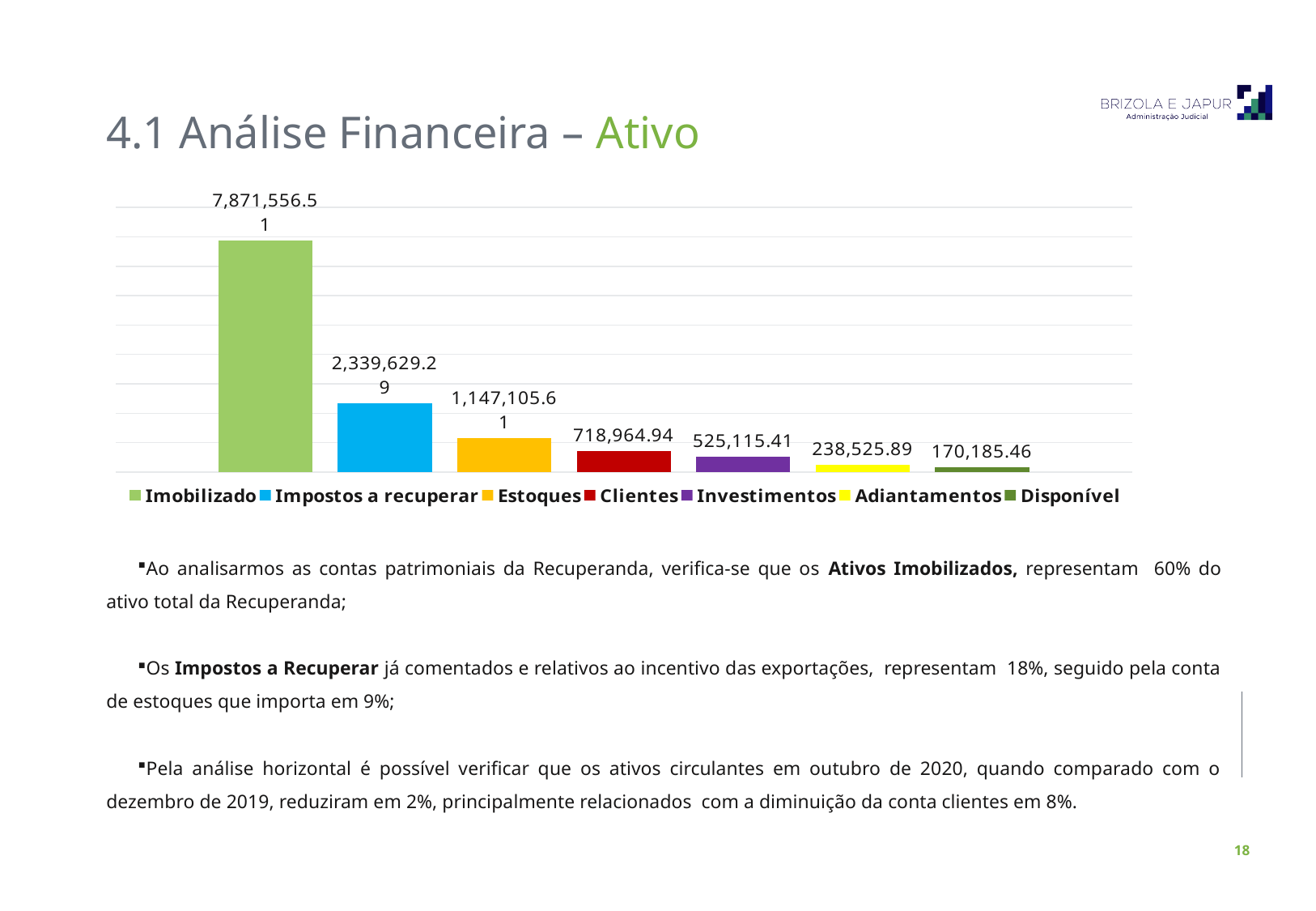
How many series does the legend list? 7 What is the value shown for Clientes? 718,964.94 Which category has the highest value in the chart? Imobilizado What is the value shown for Disponível? 170,185.46 What is the value shown for Estoques? 1,147,105.61 What is the difference between the values for Investimentos and Adiantamentos? 286,589.52 What is the value shown for Impostos a recuperar? 2,339,629.29 Which is larger, the value for Clientes or the value for Investimentos? Clientes What is the value shown for Imobilizado? 7,871,556.51 Which category has the lowest value in the chart? Disponível What colour is the bar for Impostos a recuperar? Blue What kind of chart is shown on the slide? Bar chart